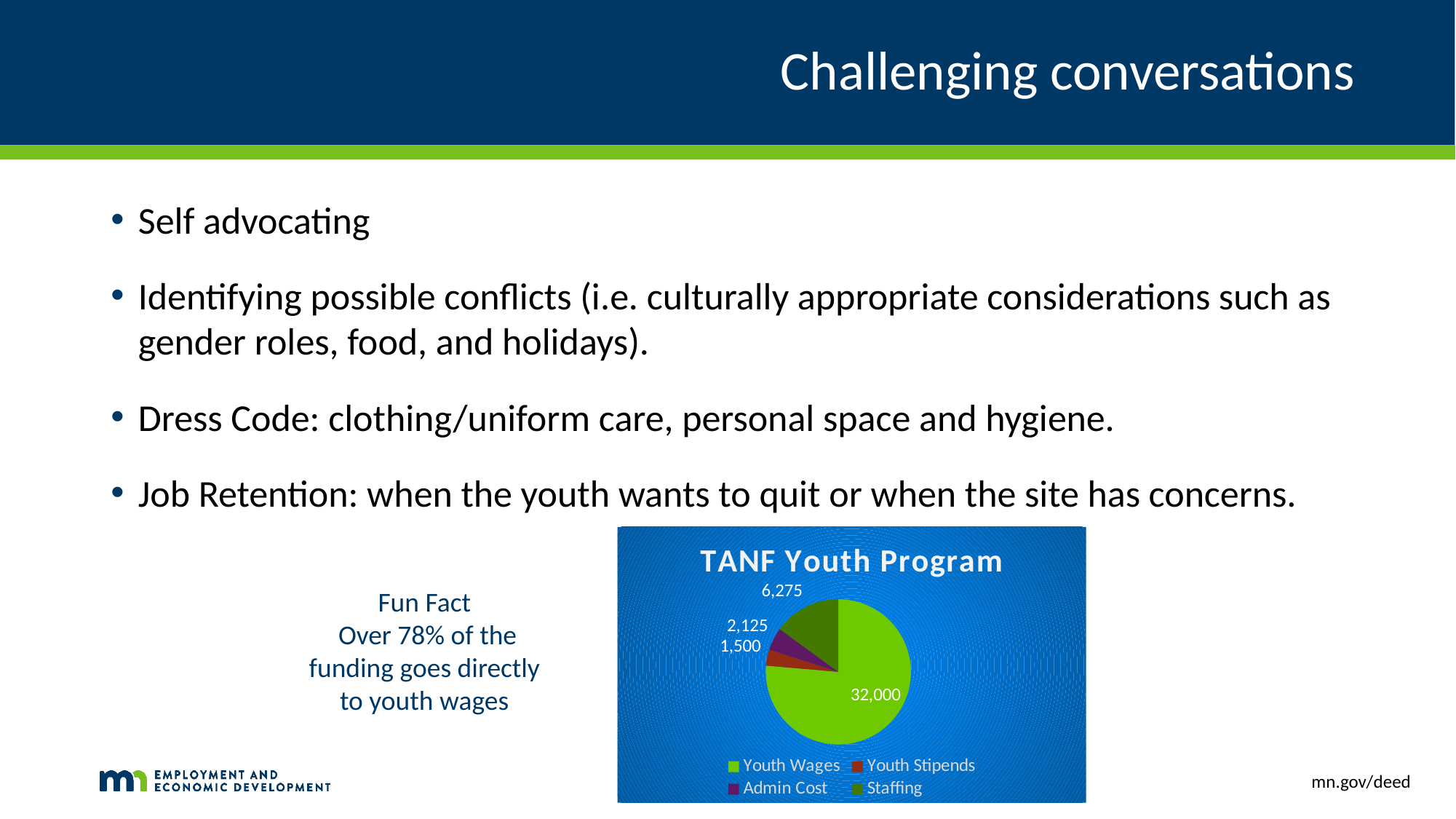
Which is larger in the TANF Youth Program chart, Staffing or Admin Cost? Staffing How many categories does the legend of the TANF Youth Program chart list? 4 What is the value for Youth Wages in the TANF Youth Program chart? 32,000 Which category has the smallest slice in the TANF Youth Program chart? Youth Stipends What is the value for Admin Cost in the TANF Youth Program chart? 2,125 What is the difference between the Youth Wages value and the Staffing value? 25,725 What is the total of all slices in the TANF Youth Program chart? 41,900 What is the value for Youth Stipends in the TANF Youth Program chart? 1,500 What is the value for Staffing in the TANF Youth Program chart? 6,275 Which category has the largest slice in the TANF Youth Program chart? Youth Wages What type of chart is shown on the slide? Pie chart What is the title of the chart? TANF Youth Program